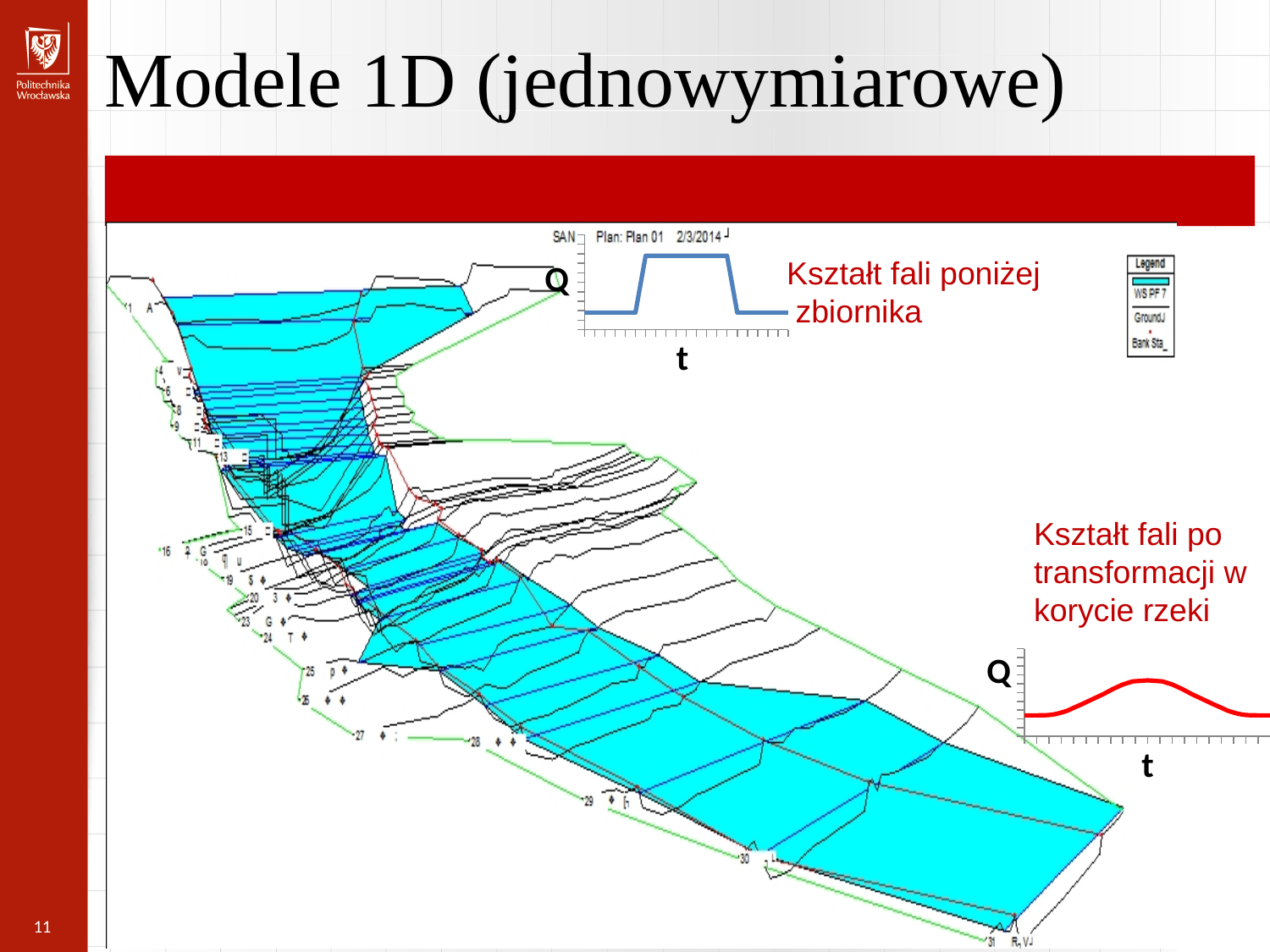
In the chart "Kształt fali po transformacji w korycie rzeki", does the red line rise, fall, or rise and then fall along the t axis? rise and then fall What kind of chart is the small chart labelled "Kształt fali poniżej zbiornika" at the top of the slide? line chart What kind of chart is the small chart labelled "Kształt fali po transformacji w korycie rzeki" at the bottom right of the slide? line chart In the chart "Kształt fali poniżej zbiornika", what is the label on the vertical axis? Q In the chart "Kształt fali po transformacji w korycie rzeki", what is the label on the horizontal axis? t In the chart "Kształt fali poniżej zbiornika", does the line rise, fall, or rise and then fall along the t axis? rise and then fall